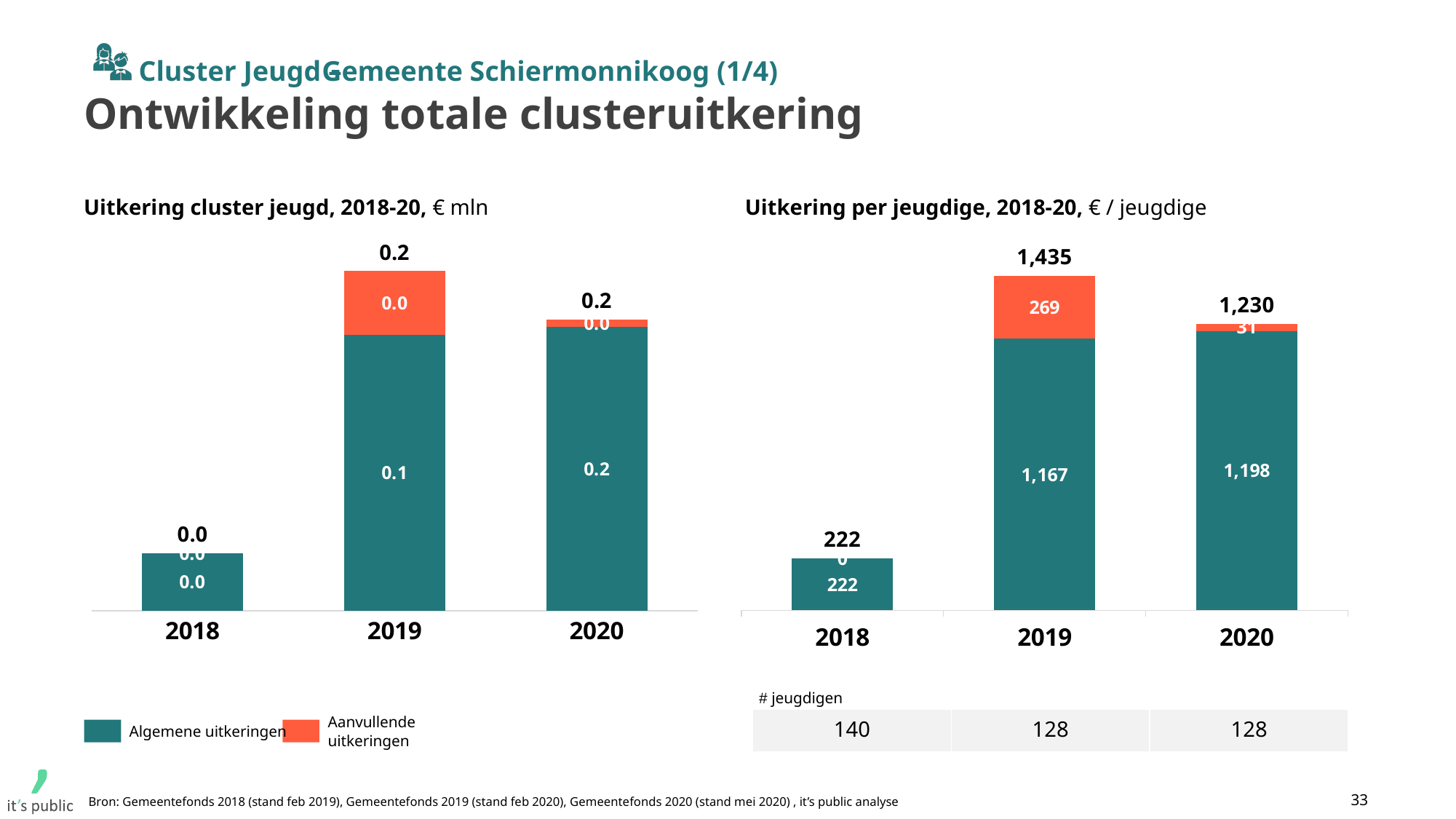
In the chart 'Uitkering per jeugdige, 2018-20', what is the total value for 2019? 1,435 What type of chart is 'Uitkering per jeugdige, 2018-20'? Stacked bar chart In the chart 'Uitkering per jeugdige, 2018-20', what is the Algemene uitkeringen value for 2020? 1,198 In the chart 'Uitkering per jeugdige, 2018-20', which year has the lowest total? 2018 In the chart 'Uitkering cluster jeugd, 2018-20', what is the Algemene uitkeringen value for 2019? 0.1 How many years are shown on the x axis of the chart 'Uitkering cluster jeugd, 2018-20'? 3 In the chart 'Uitkering per jeugdige, 2018-20', what is the difference between the totals for 2019 and 2020? 205 In the chart 'Uitkering per jeugdige, 2018-20', what is the Aanvullende uitkeringen value for 2019? 269 In the chart 'Uitkering per jeugdige, 2018-20', which year has the highest total? 2019 In the chart 'Uitkering per jeugdige, 2018-20', is the Algemene uitkeringen value larger in 2019 or in 2020? 2020 In the chart 'Uitkering cluster jeugd, 2018-20', what is the total value for 2020? 0.2 How many series does the legend of the chart 'Uitkering cluster jeugd, 2018-20' list? 2